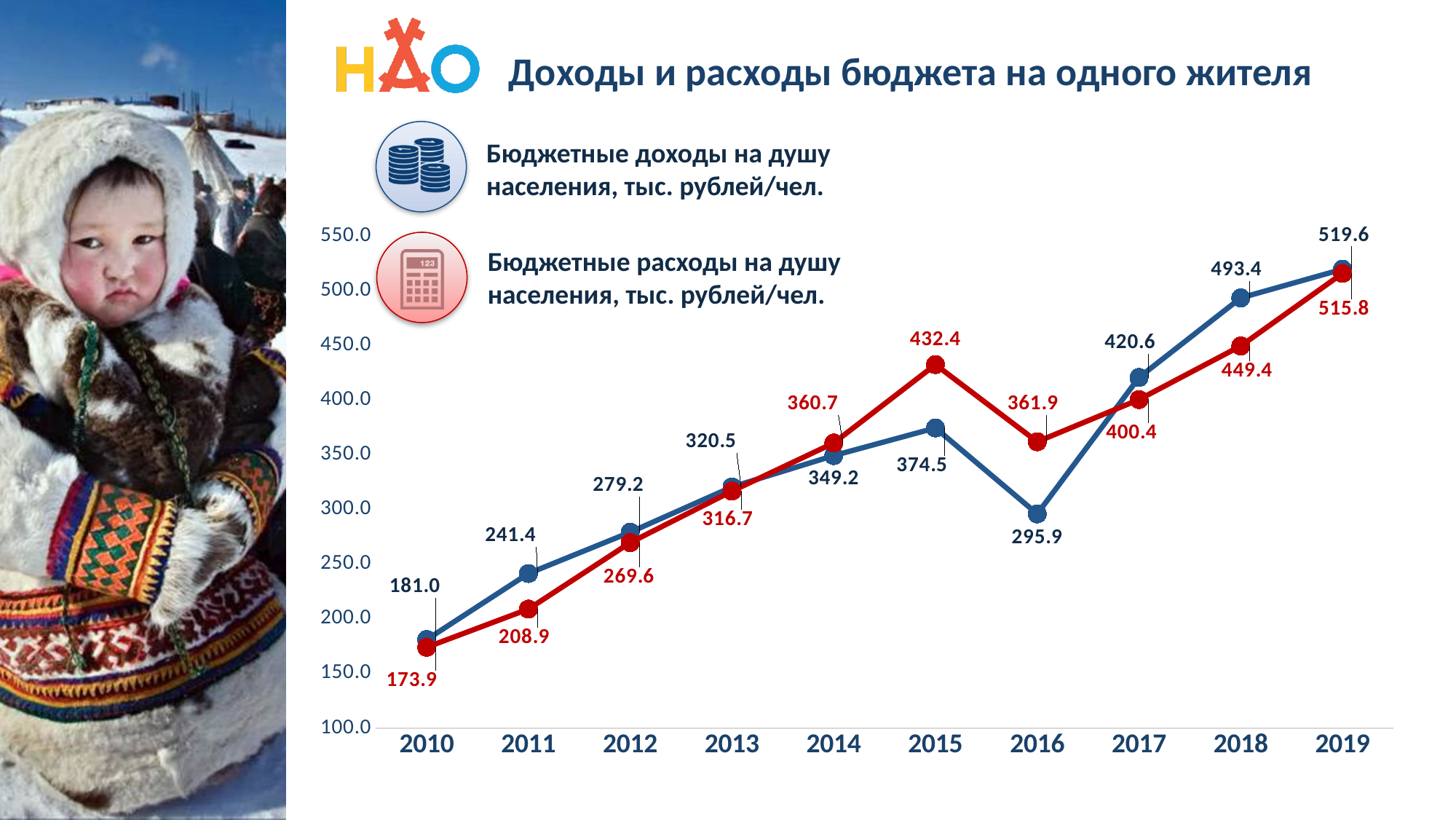
Which is larger in 2018: budget revenue per capita or budget expenditure per capita? Budget revenue per capita (493.4) What is the budget revenue per capita (Бюджетные доходы на душу населения) in 2016? 295.9 What is the difference between budget revenue per capita and budget expenditure per capita in 2015? 57.9 Which colour represents budget expenditure per capita (Бюджетные расходы на душу населения) in the chart? Red How many years are shown on the x axis of the chart? 10 What kind of chart is shown on the slide? Line chart In which year is the budget expenditure per capita the highest? 2019 In which year is the budget revenue per capita the lowest? 2010 What is the budget revenue per capita in 2010? 181.0 Is the budget expenditure per capita in 2017 greater or less than 450.0? less How many series does the chart's legend list? 2 What is the budget expenditure per capita (Бюджетные расходы на душу населения) in 2015? 432.4